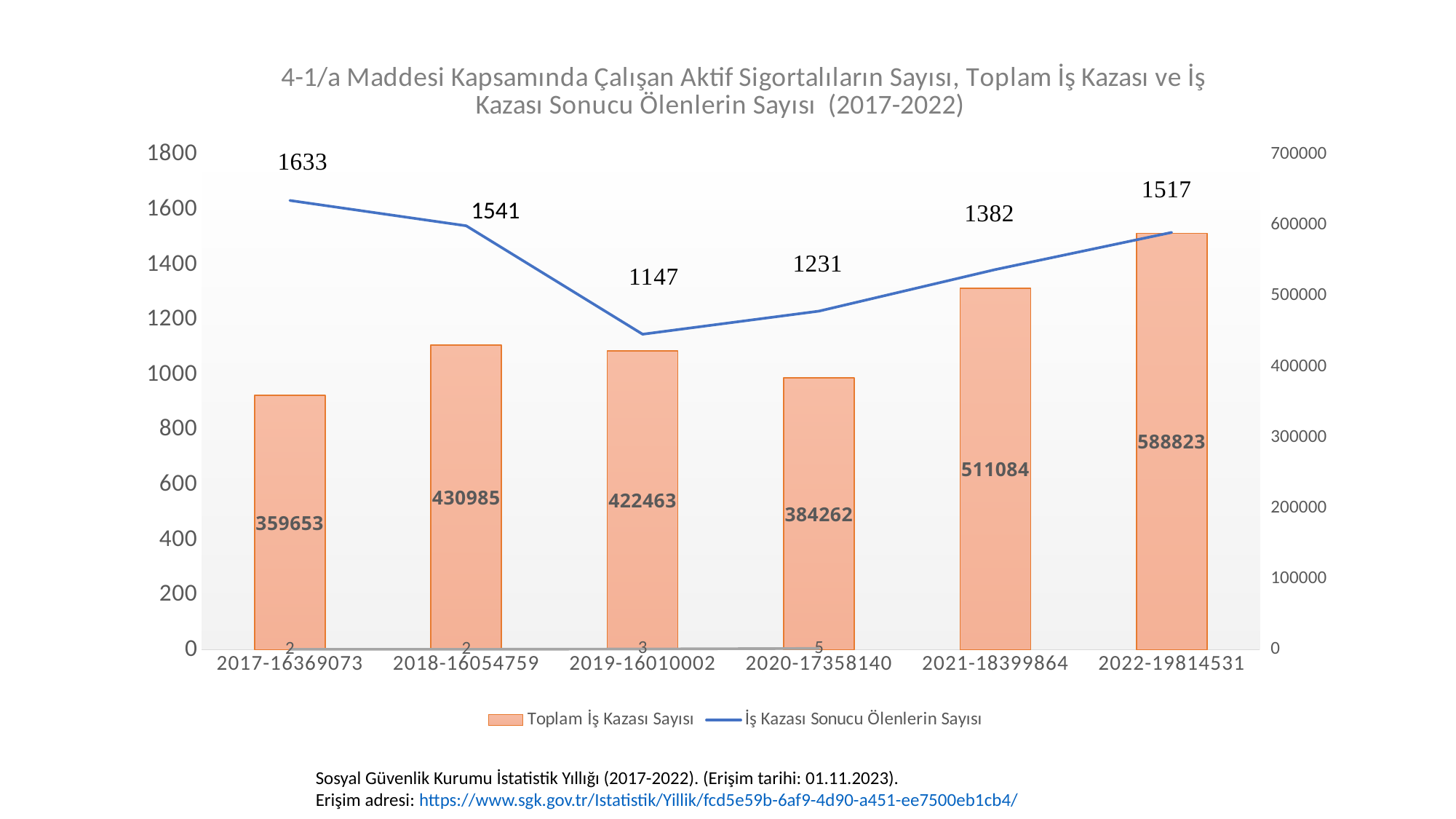
Which is larger, the Toplam İş Kazası Sayısı for 2018-16054759 or for 2019-16010002? 2018-16054759 Is the Toplam İş Kazası Sayısı for 2020-17358140 greater or less than 400000? less What is the value of Toplam İş Kazası Sayısı for 2017-16369073? 359653 Which category has the lowest İş Kazası Sonucu Ölenlerin Sayısı? 2019-16010002 What is the difference in İş Kazası Sonucu Ölenlerin Sayısı between 2017-16369073 and 2018-16054759? 92 How many series does the legend list? 2 Does the İş Kazası Sonucu Ölenlerin Sayısı line rise or fall from 2019-16010002 to 2022-19814531? rise What is the difference in Toplam İş Kazası Sayısı between 2022-19814531 and 2021-18399864? 77739 What is the value of İş Kazası Sonucu Ölenlerin Sayısı for 2019-16010002? 1147 How is the Toplam İş Kazası Sayısı series plotted, as bars or as a line? bars Which category has the highest Toplam İş Kazası Sayısı? 2022-19814531 How many categories are shown on the x axis? 6